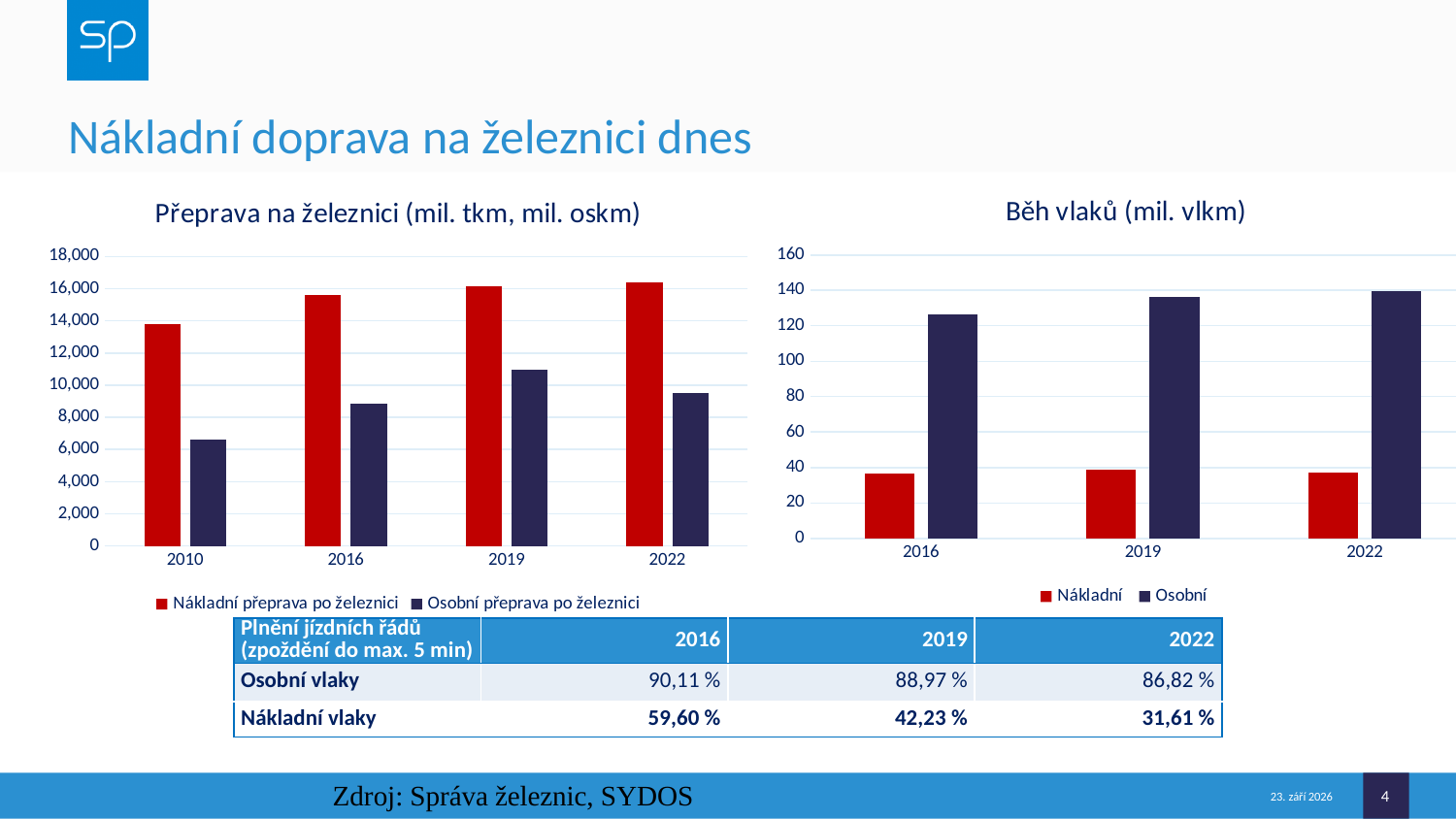
On the chart titled 'Přeprava na železnici (mil. tkm, mil. oskm)', which series has the larger value in 2016, Nákladní přeprava po železnici or Osobní přeprava po železnici? Nákladní přeprava po železnici On the chart titled 'Běh vlaků (mil. vlkm)', how many series does the legend list? 2 On the chart titled 'Přeprava na železnici (mil. tkm, mil. oskm)', in which year is Osobní přeprava po železnici lowest? 2010 On the chart titled 'Přeprava na železnici (mil. tkm, mil. oskm)', how many years are shown on the x axis? 4 On the chart titled 'Běh vlaků (mil. vlkm)', is the value for Nákladní in 2016 greater or less than 40? less On the chart titled 'Přeprava na železnici (mil. tkm, mil. oskm)', in which year is Osobní přeprava po železnici highest? 2019 On the chart titled 'Běh vlaků (mil. vlkm)', is the value for Osobní in 2016 greater or less than 120? greater On the chart titled 'Běh vlaků (mil. vlkm)', do the Osobní values rise or fall from 2016 to 2022? rise On the chart titled 'Přeprava na železnici (mil. tkm, mil. oskm)', is the value for Osobní přeprava po železnici in 2010 greater or less than 8,000? less On the chart titled 'Běh vlaků (mil. vlkm)', in which year is Osobní lowest? 2016 On the chart titled 'Přeprava na železnici (mil. tkm, mil. oskm)', what kind of chart is shown? bar chart